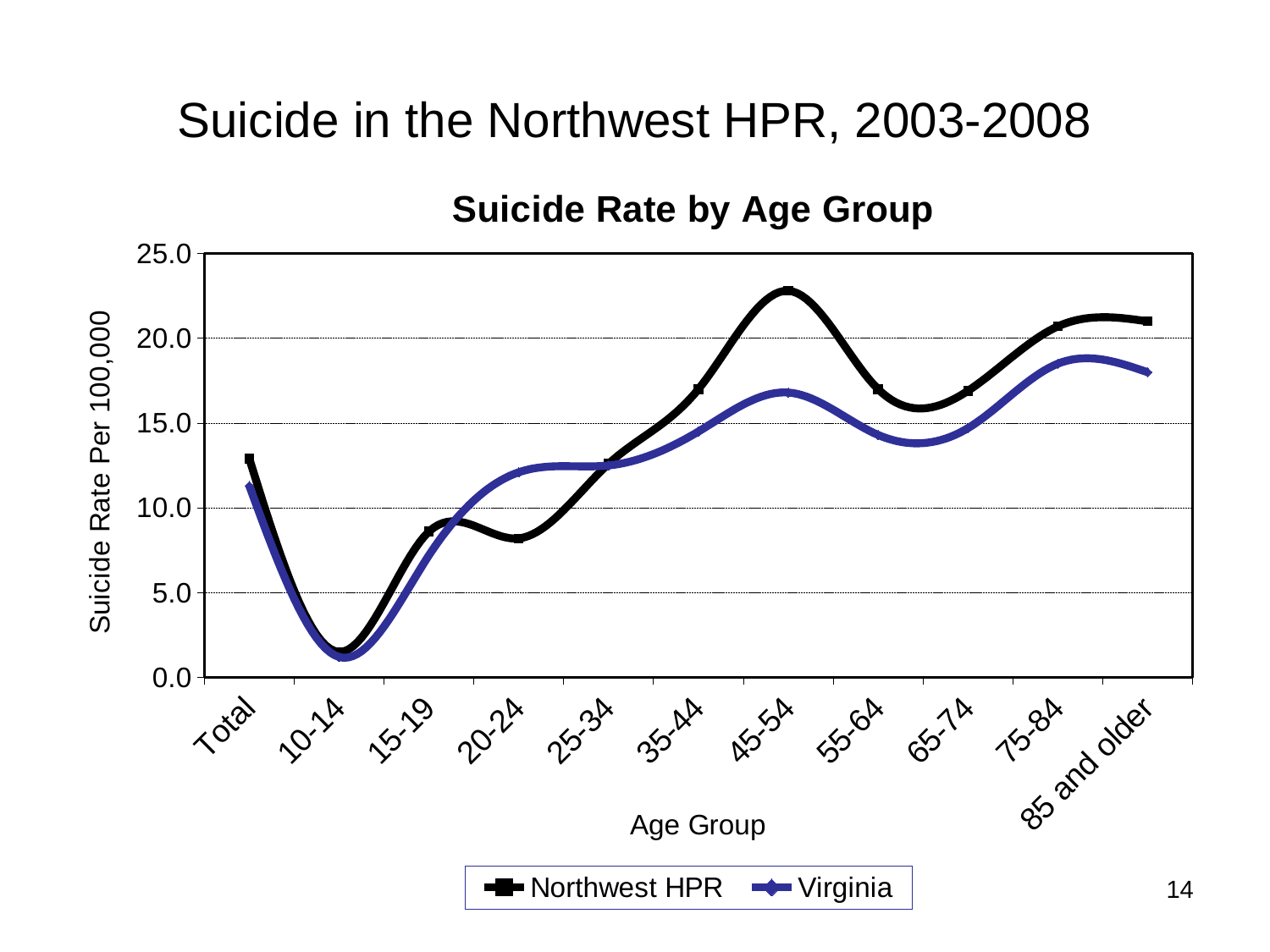
How many series does the legend list? 2 What type of chart is shown on the slide? line chart How many age group categories are shown on the x axis? 11 What is the label of the y axis? Suicide Rate Per 100,000 For the 45-54 age group, which series has the higher suicide rate, Northwest HPR or Virginia? Northwest HPR For the 20-24 age group, which series has the higher suicide rate, Northwest HPR or Virginia? Virginia Is the Virginia value for 20-24 greater or less than 10.0? greater Which age group has the lowest suicide rate for Northwest HPR? 10-14 Is the Northwest HPR value for 45-54 greater or less than 20.0? greater Is the Northwest HPR value for 20-24 greater or less than 10.0? less Which age group has the highest suicide rate for Northwest HPR? 45-54